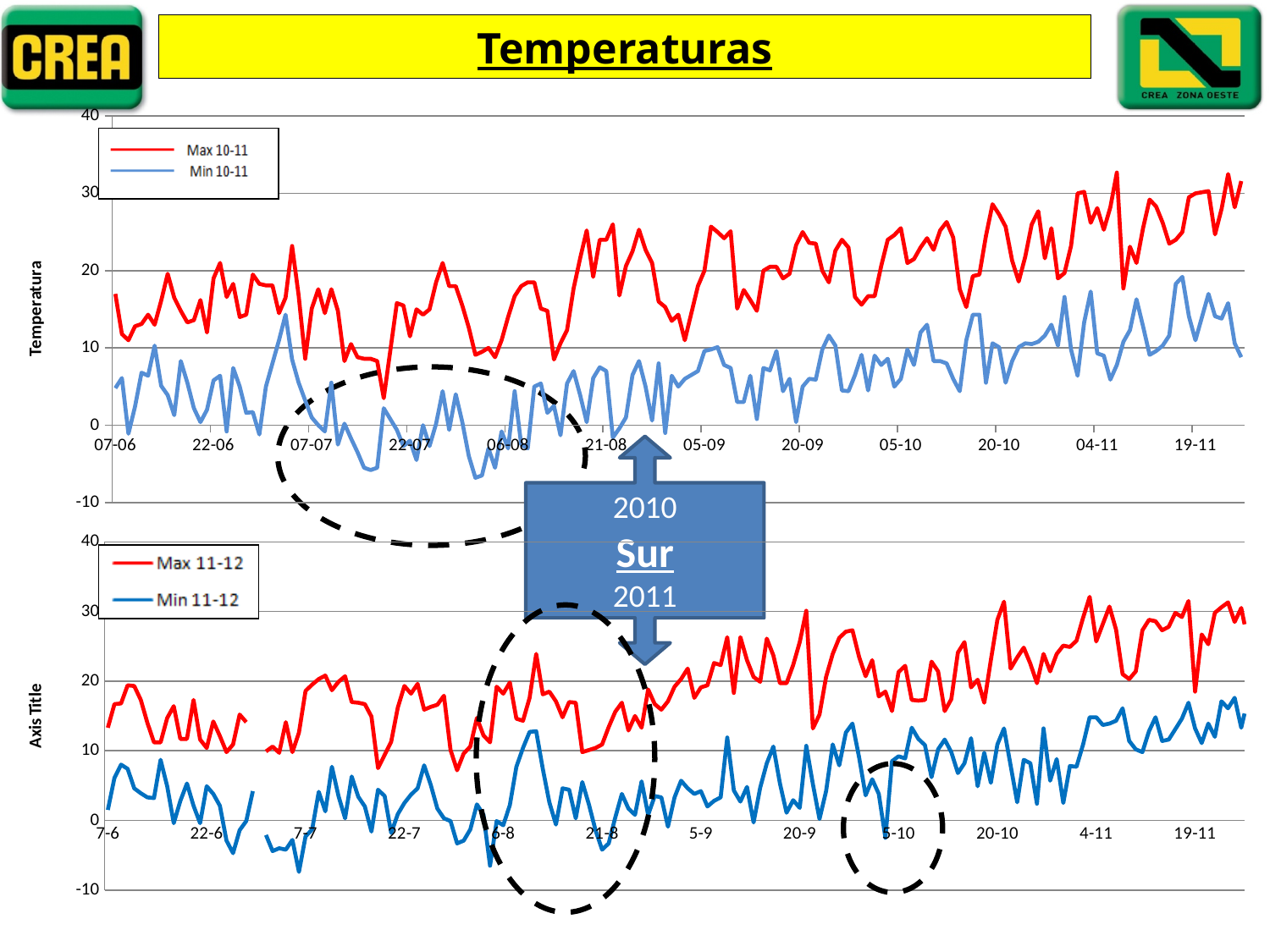
In the bottom chart, is the Max 11-12 value at 19-11 greater or less than 20? greater In the top chart, at 19-11, which series has the larger value, Max 10-11 or Min 10-11? Max 10-11 How many series does the legend of the top chart list? 2 In the top chart, does the Max 10-11 series generally rise or fall from 07-06 to 19-11? rise What kind of chart is the top chart (Max 10-11 / Min 10-11)? line chart What is the y-axis title of the bottom chart? Axis Title In the top chart, is the Min 10-11 value at 22-07 greater or less than 10? less In the top chart, is the Max 10-11 value at 07-06 greater or less than 10? greater How many series does the legend of the bottom chart list? 2 What are the legend entries of the top chart? Max 10-11, Min 10-11 In the bottom chart, does the Min 11-12 series generally rise or fall from 7-6 to 19-11? rise